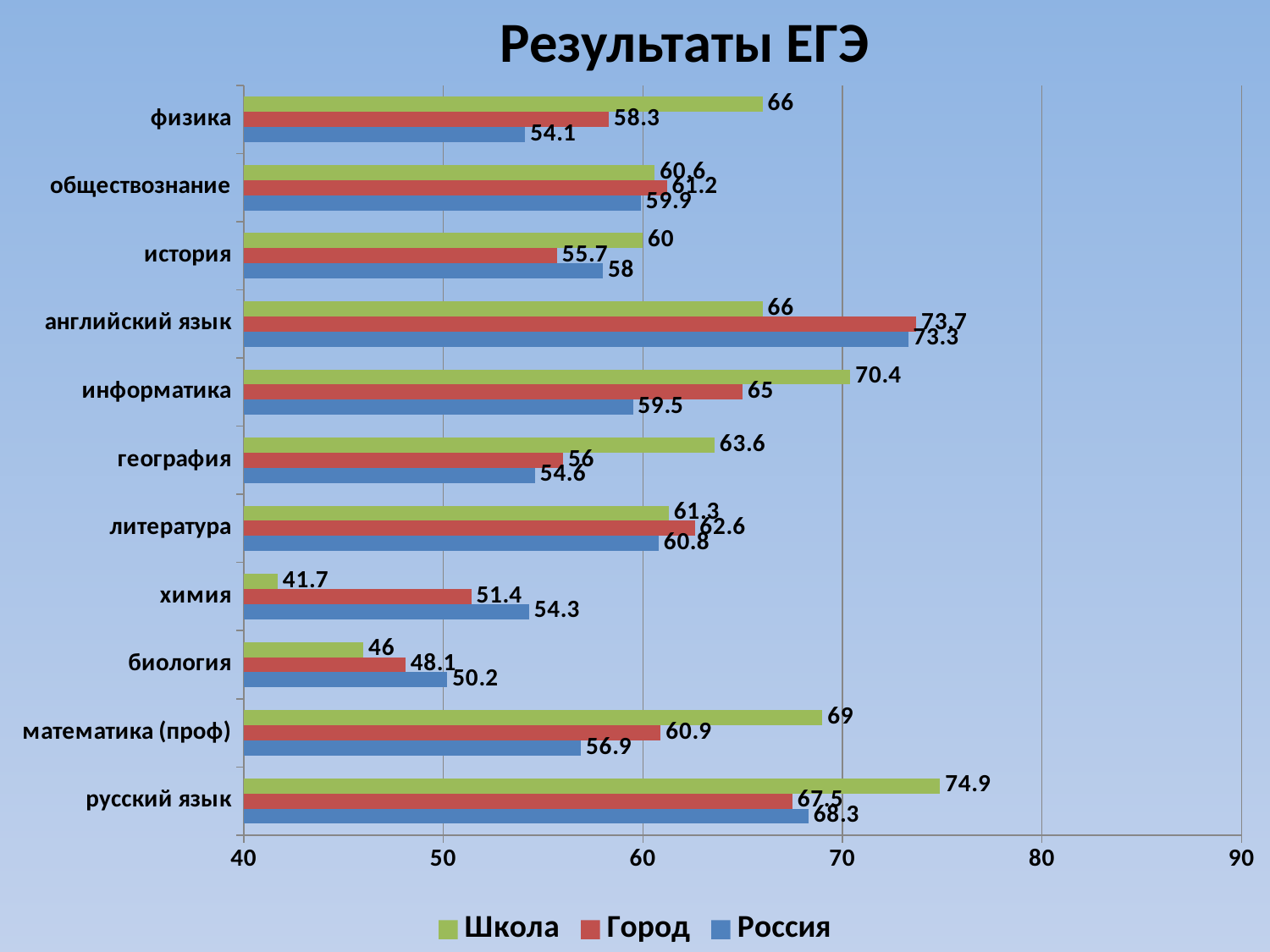
What kind of chart is shown on the slide? bar chart Is the Школа value for математика (проф) greater or less than 60? greater How many series does the legend list? 3 How many categories (subjects) are shown on the chart? 11 Which category has the lowest Школа value? химия What is the difference between the Школа and Россия values for физика? 11.9 What is the Россия value for химия? 54.3 What is the Школа value for информатика? 70.4 What is the Город value for английский язык? 73.7 Which is larger for биология: the Город value or the Россия value? Россия Which category has the highest Школа value? русский язык What is the title of the chart? Результаты ЕГЭ